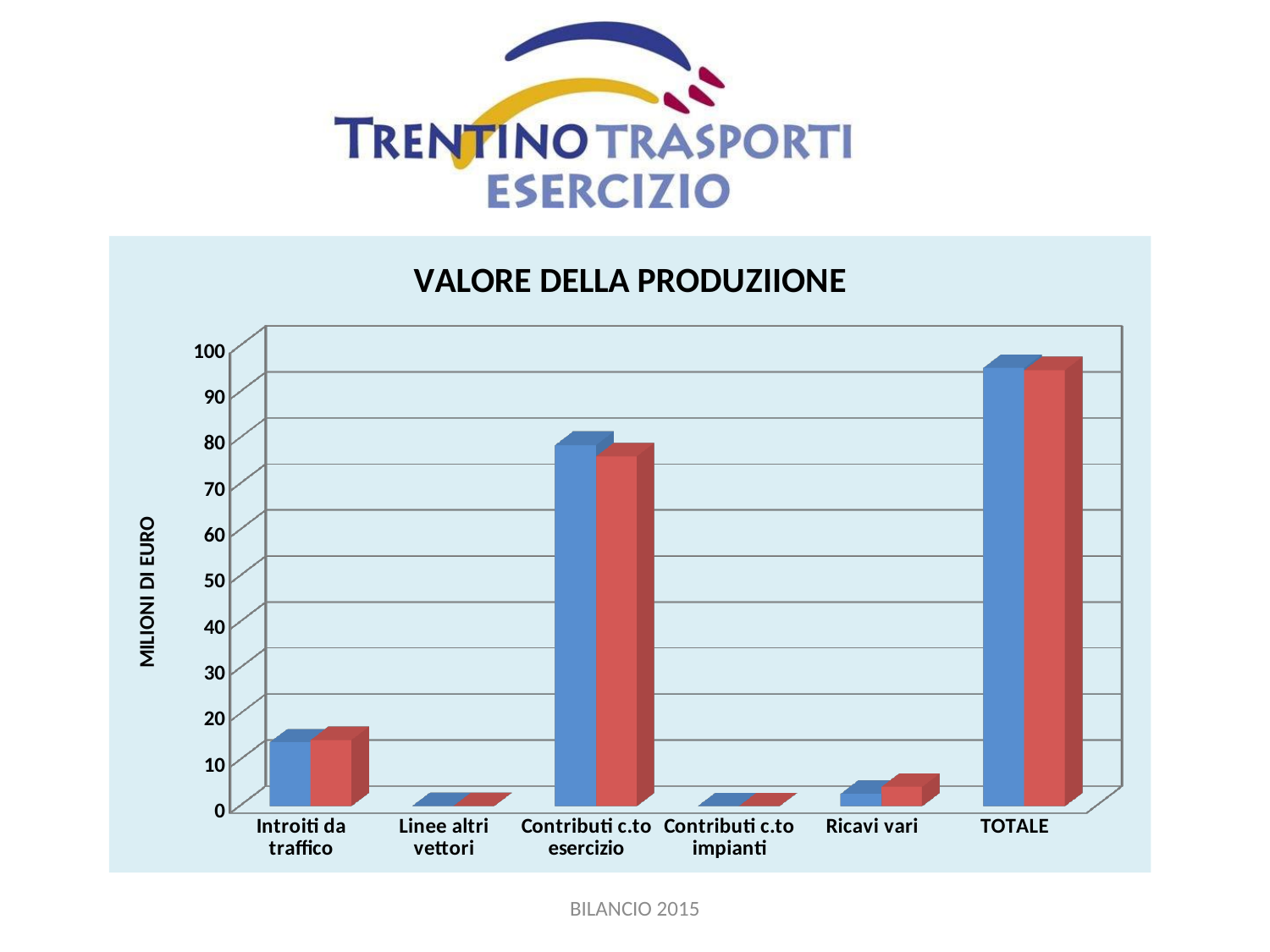
How many categories are shown on the x axis of the chart? 6 Which category has larger bars, Contributi c.to esercizio or Introiti da traffico? Contributi c.to esercizio Is the value of the blue bar for Contributi c.to esercizio greater or less than 70? greater What kind of chart is shown on the slide? bar chart What is the label on the vertical axis of the chart? MILIONI DI EURO Is the value of the blue bar for TOTALE greater or less than 90? greater Is the value of the blue bar for Ricavi vari greater or less than 10? less What is the title of the chart? VALORE DELLA PRODUZIIONE Which category has the highest bars in the chart? TOTALE Which category has larger bars, Ricavi vari or Introiti da traffico? Introiti da traffico